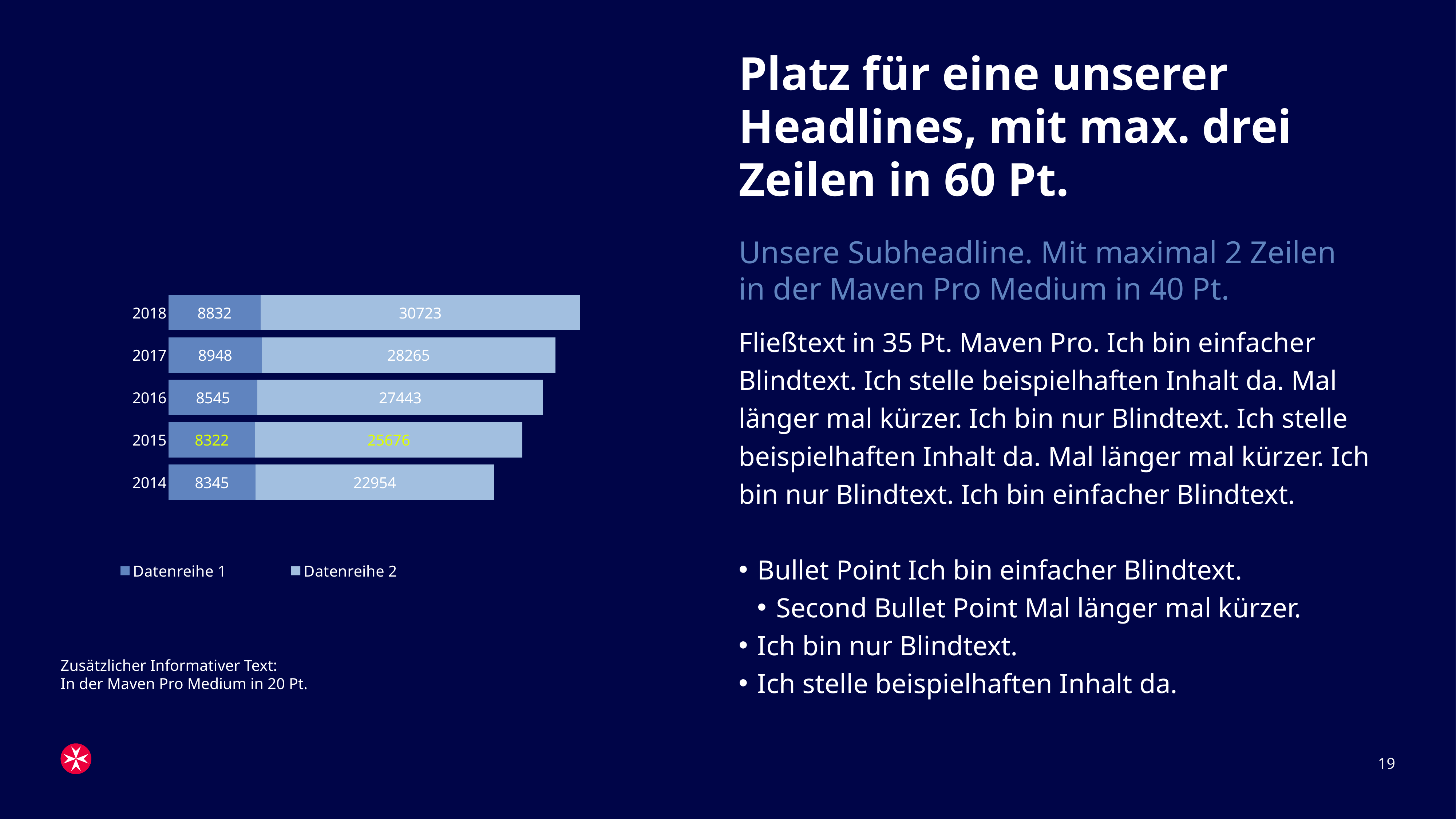
What is the difference between the Datenreihe 2 values for 2018 and 2014? 7769 How many years are shown in the chart? 5 Which year has the highest value for Datenreihe 1? 2017 Which year has the lowest value for Datenreihe 2? 2014 Which is larger, Datenreihe 1 for 2016 or Datenreihe 1 for 2014? 2016 How many series does the legend list? 2 What is the total of the stacked bar for 2017? 37213 What is the value of Datenreihe 2 for 2018? 30723 What is the value of Datenreihe 1 for 2015? 8322 What kind of chart is shown on the slide? Stacked bar chart What is the value of Datenreihe 2 for 2014? 22954 Does Datenreihe 2 increase or decrease from 2014 to 2018? Increase